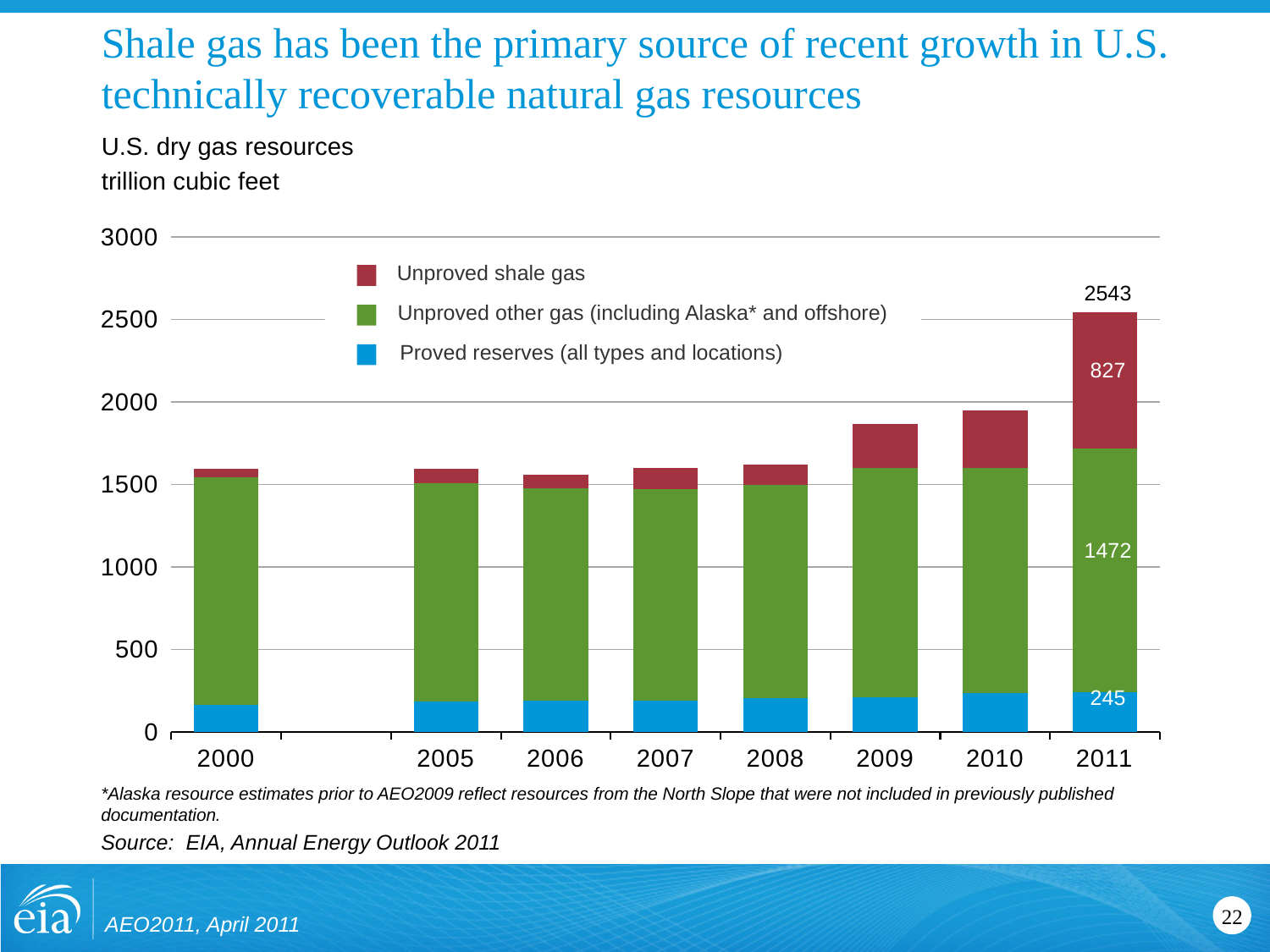
What is the value of unproved other gas (including Alaska and offshore) in 2011? 1472 Is the total value for 2010 greater or less than 2000? greater In 2011, which is larger: unproved shale gas or proved reserves? Unproved shale gas Is the total value for 2008 greater or less than 1500? greater What is the value of proved reserves (all types and locations) in 2011? 245 Which year has the highest total dry gas resources? 2011 How many series does the legend list? 3 What is the value of unproved shale gas in 2011? 827 What is the total of the stacked bar for 2011? 2543 How many years are shown on the x axis? 8 What is the difference between unproved other gas and unproved shale gas in 2011? 645 What kind of chart is shown on the slide? Stacked bar chart